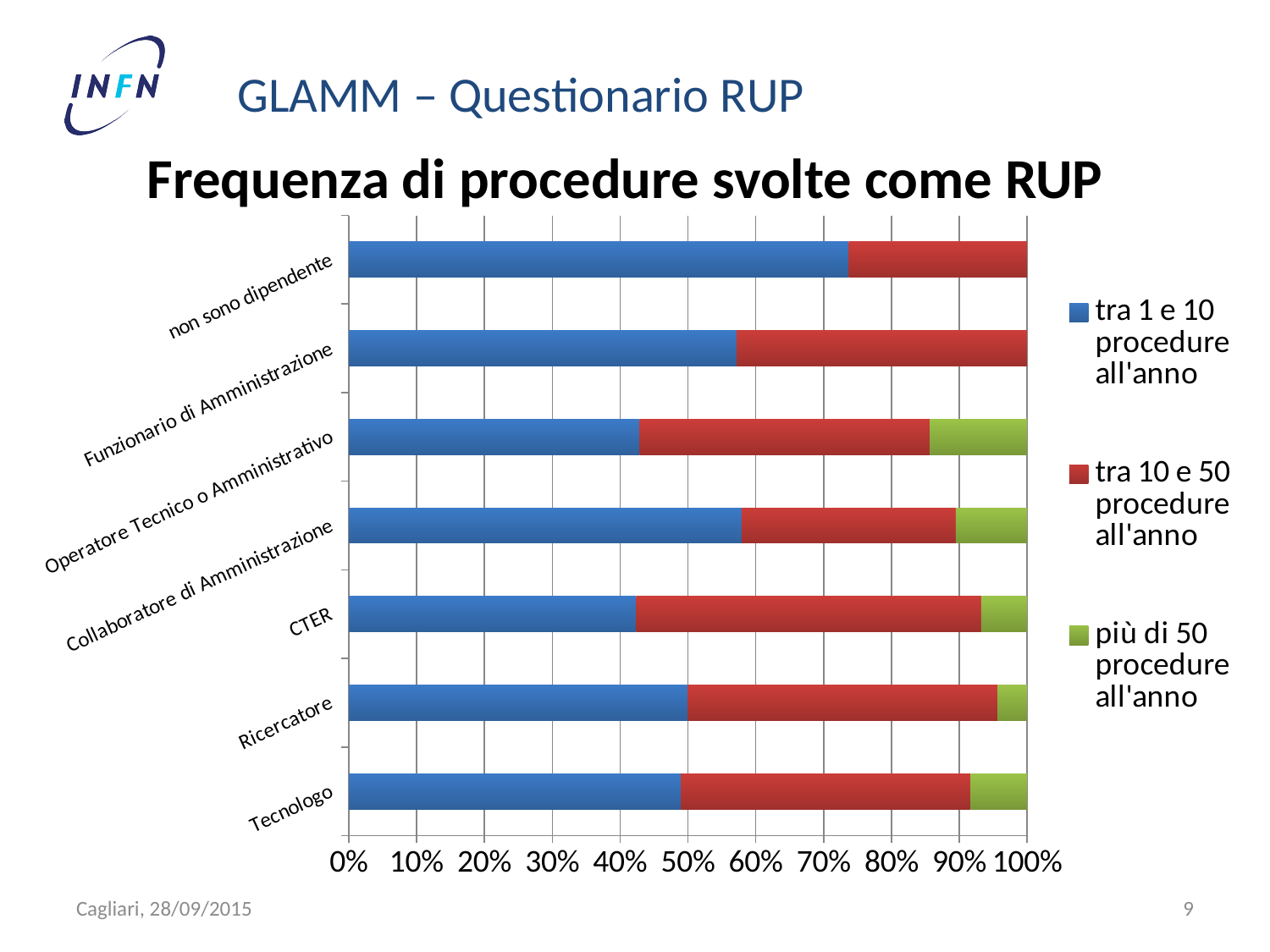
Is the share of 'tra 1 e 10 procedure all'anno' for 'Funzionario di Amministrazione' greater or less than 50%? greater Is the share of 'più di 50 procedure all'anno' for Ricercatore greater or less than 10%? less What is the total of the stacked bar for Tecnologo? 100% Which category has the largest share of 'tra 1 e 10 procedure all'anno'? non sono dipendente What kind of chart is shown on the slide? bar chart Is the share of 'tra 1 e 10 procedure all'anno' for CTER greater or less than 50%? less What is the title of the chart? Frequenza di procedure svolte come RUP Which category has the largest share of 'più di 50 procedure all'anno'? Operatore Tecnico o Amministrativo How many series does the legend list? 3 How many categories (job roles) are shown on the vertical axis of the chart? 7 Which has a larger share of 'tra 1 e 10 procedure all'anno': 'non sono dipendente' or CTER? non sono dipendente